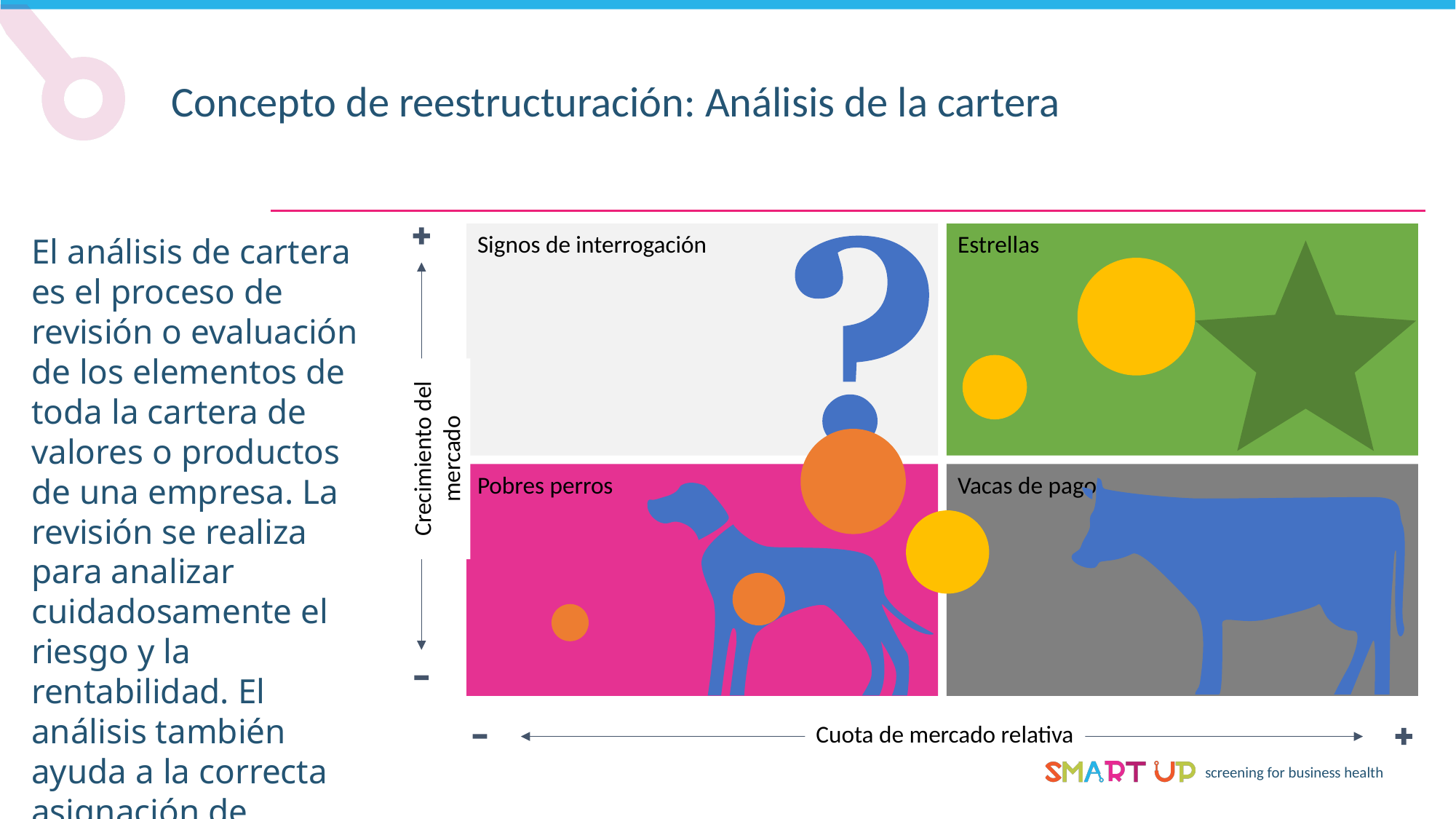
What is the label on the horizontal axis of the matrix? Cuota de mercado relativa Which quadrant is in the top-right position of the matrix? Estrellas Which quadrant is in the top-left position of the matrix? Signos de interrogación Which quadrant is in the bottom-left position of the matrix? Pobres perros How many quadrants does the matrix have? 4 Which quadrant is in the bottom-right position of the matrix? Vacas de pago What is the label on the vertical axis of the matrix? Crecimiento del mercado